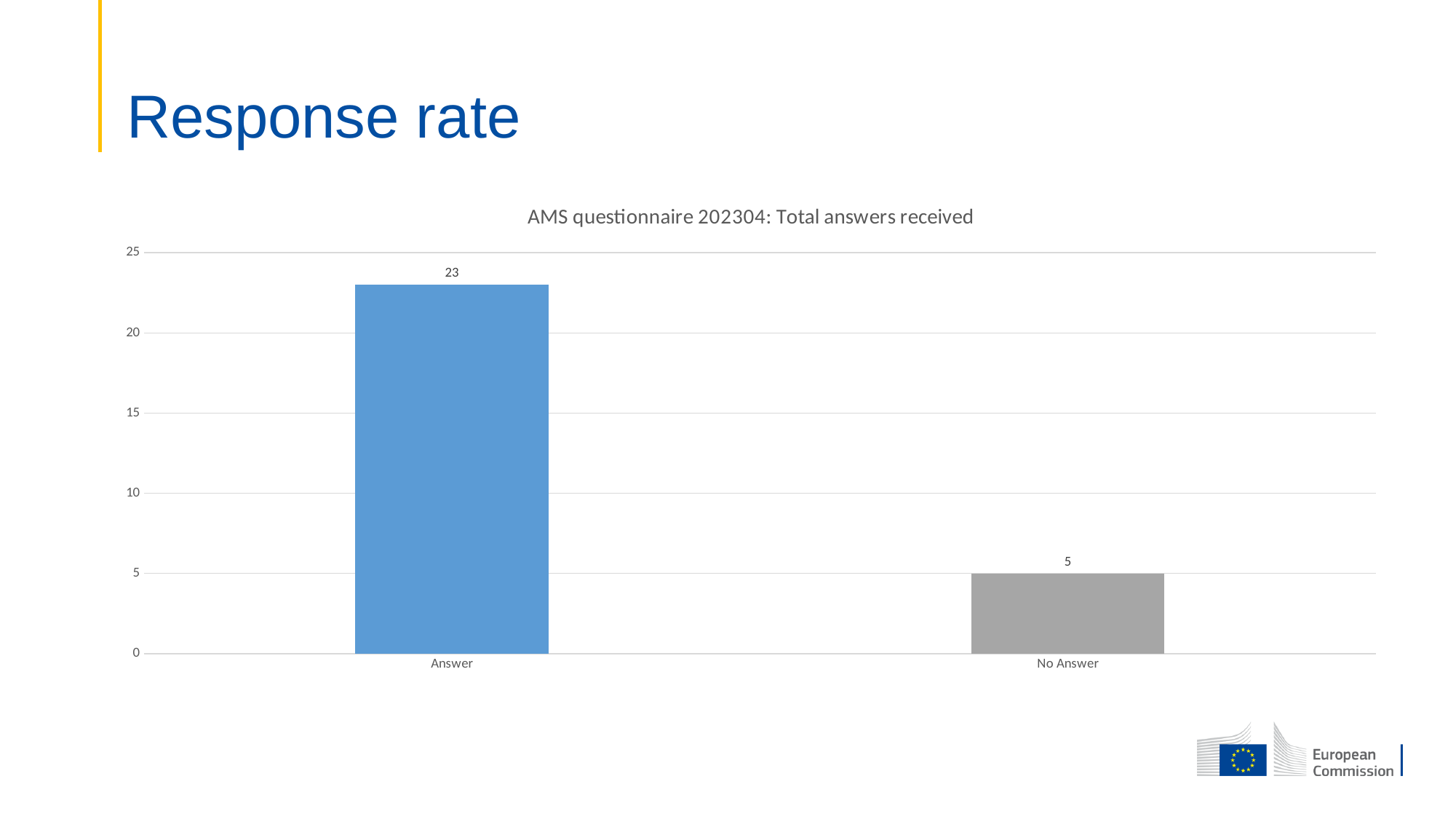
Which is larger, the value for Answer or the value for No Answer? Answer Is the value for No Answer greater or less than 10? less What is the value for Answer? 23 Which category has the highest value? Answer What is the title of the chart? AMS questionnaire 202304: Total answers received Which category has the lowest value? No Answer What kind of chart is shown on the slide? bar chart What colour is the bar for Answer? blue Is the value for Answer greater or less than 20? greater How many categories are shown on the x axis? 2 What is the difference between the values for Answer and No Answer? 18 What is the value for No Answer? 5